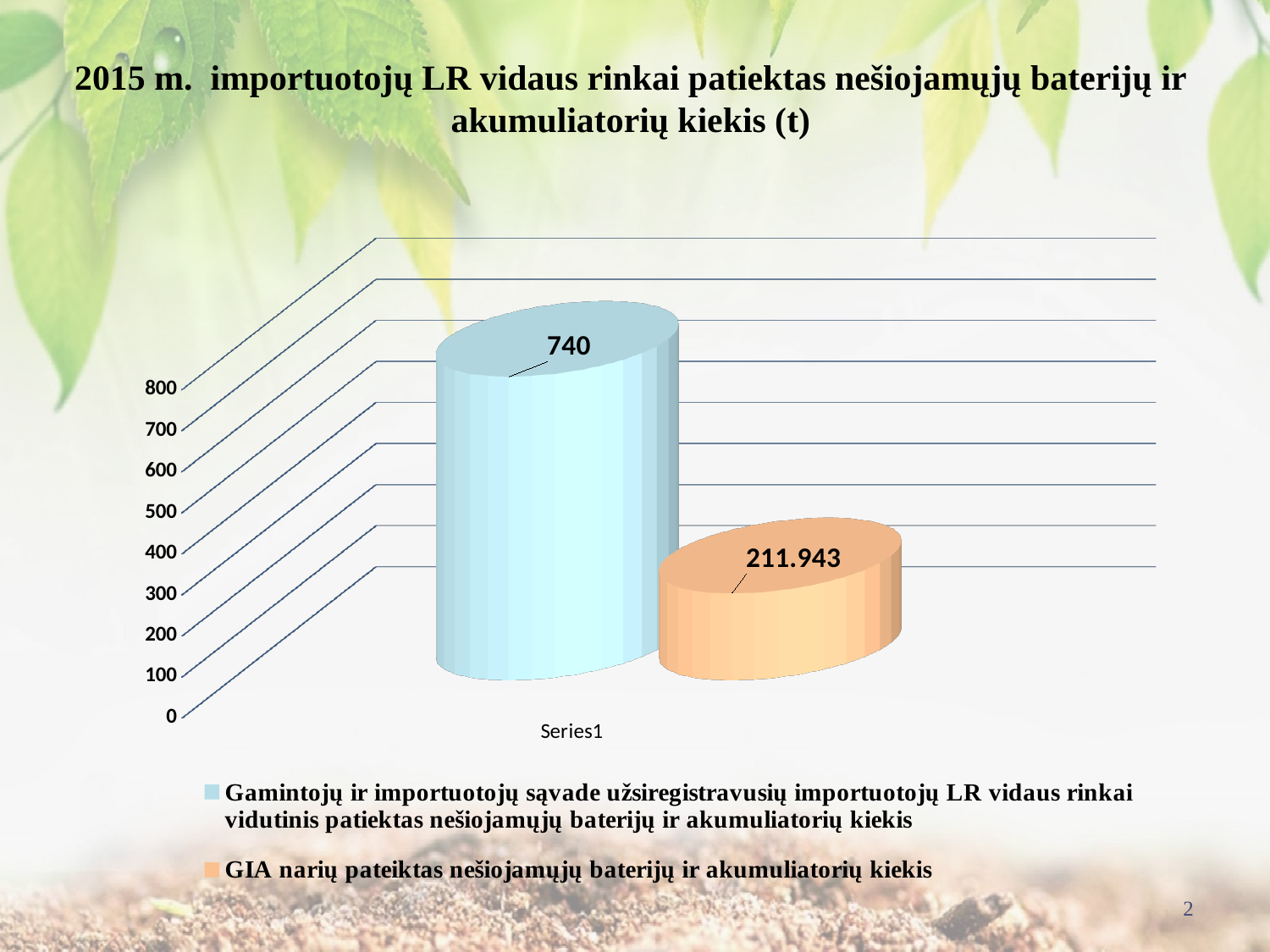
Is the value for the blue series larger or smaller than the value for the orange series? larger Which series has the higher value? Gamintojų ir importuotojų sąvade užsiregistravusių importuotojų LR vidaus rinkai vidutinis patiektas nešiojamųjų baterijų ir akumuliatorių kiekis Is the value for 'GIA narių pateiktas nešiojamųjų baterijų ir akumuliatorių kiekis' greater or less than 300? less What value is shown for the series 'Gamintojų ir importuotojų sąvade užsiregistravusių importuotojų LR vidaus rinkai vidutinis patiektas nešiojamųjų baterijų ir akumuliatorių kiekis'? 740 How many series does the legend list? 2 Is the value for the blue series greater or less than 700? greater What is the difference between the value 740 and the value 211.943 shown on the chart? 528.057 What is the highest value shown on the vertical axis? 800 What is the category label shown on the horizontal axis? Series1 What value is shown for the series 'GIA narių pateiktas nešiojamųjų baterijų ir akumuliatorių kiekis'? 211.943 What kind of chart is shown on the slide? bar chart Which series has the lower value? GIA narių pateiktas nešiojamųjų baterijų ir akumuliatorių kiekis